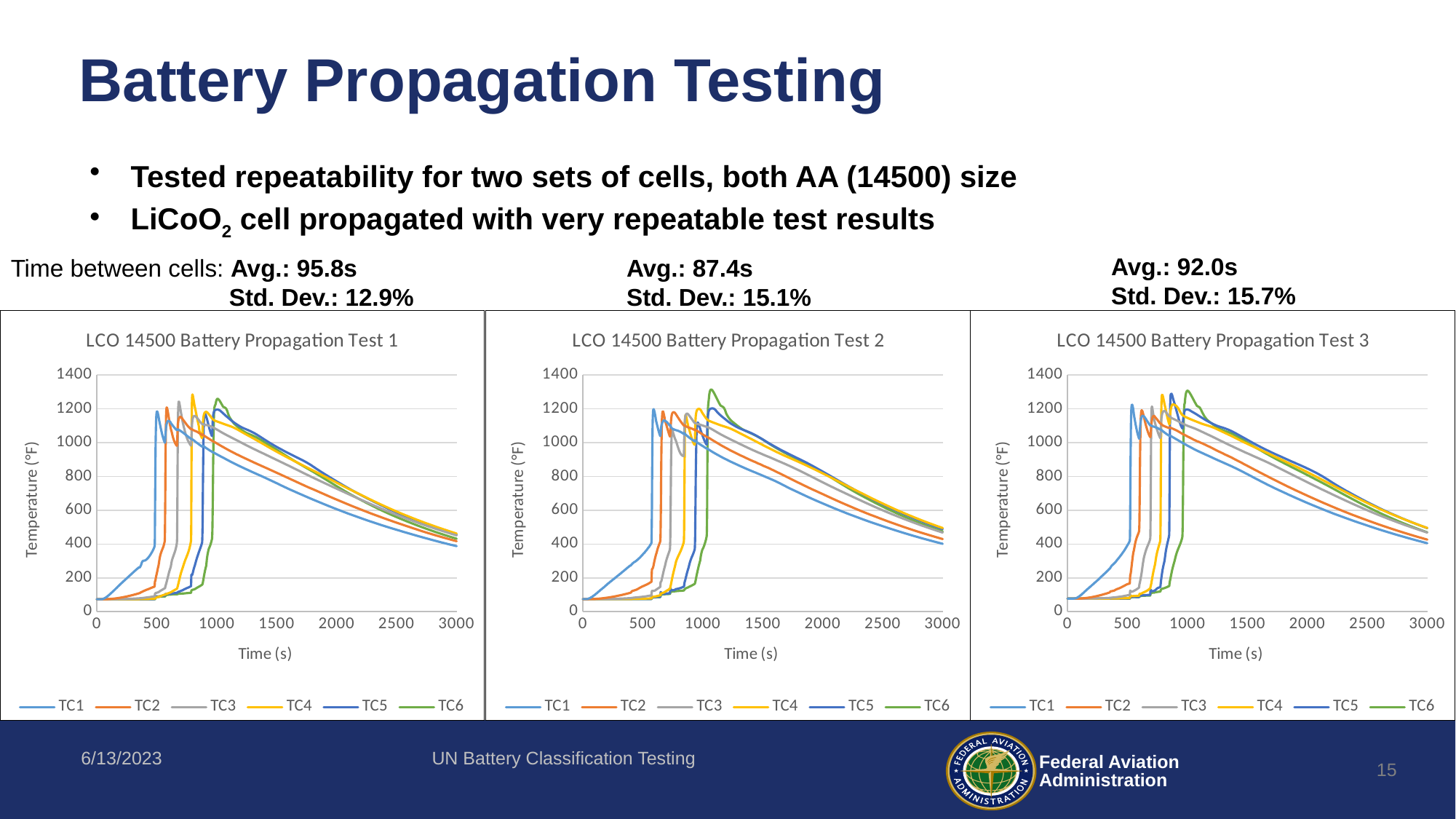
What is the y-axis label of 'LCO 14500 Battery Propagation Test 3'? Temperature (°F) In 'LCO 14500 Battery Propagation Test 2', at 3000 s, which is higher: TC1 or TC4? TC4 In 'LCO 14500 Battery Propagation Test 1', do the temperatures rise or fall between 1500 s and 3000 s? fall In 'LCO 14500 Battery Propagation Test 1', is the peak value of TC6 greater or less than 1200? greater How many series does the legend of 'LCO 14500 Battery Propagation Test 2' list? 6 In 'LCO 14500 Battery Propagation Test 2', which series reaches the highest peak temperature? TC6 In 'LCO 14500 Battery Propagation Test 3', is the value of TC1 at 3000 s greater or less than 600? less How many charts are shown on the slide? 3 What is the x-axis label of 'LCO 14500 Battery Propagation Test 1'? Time (s) In 'LCO 14500 Battery Propagation Test 2', is the peak value of TC1 greater or less than 1000? greater What kind of chart is 'LCO 14500 Battery Propagation Test 1'? line chart